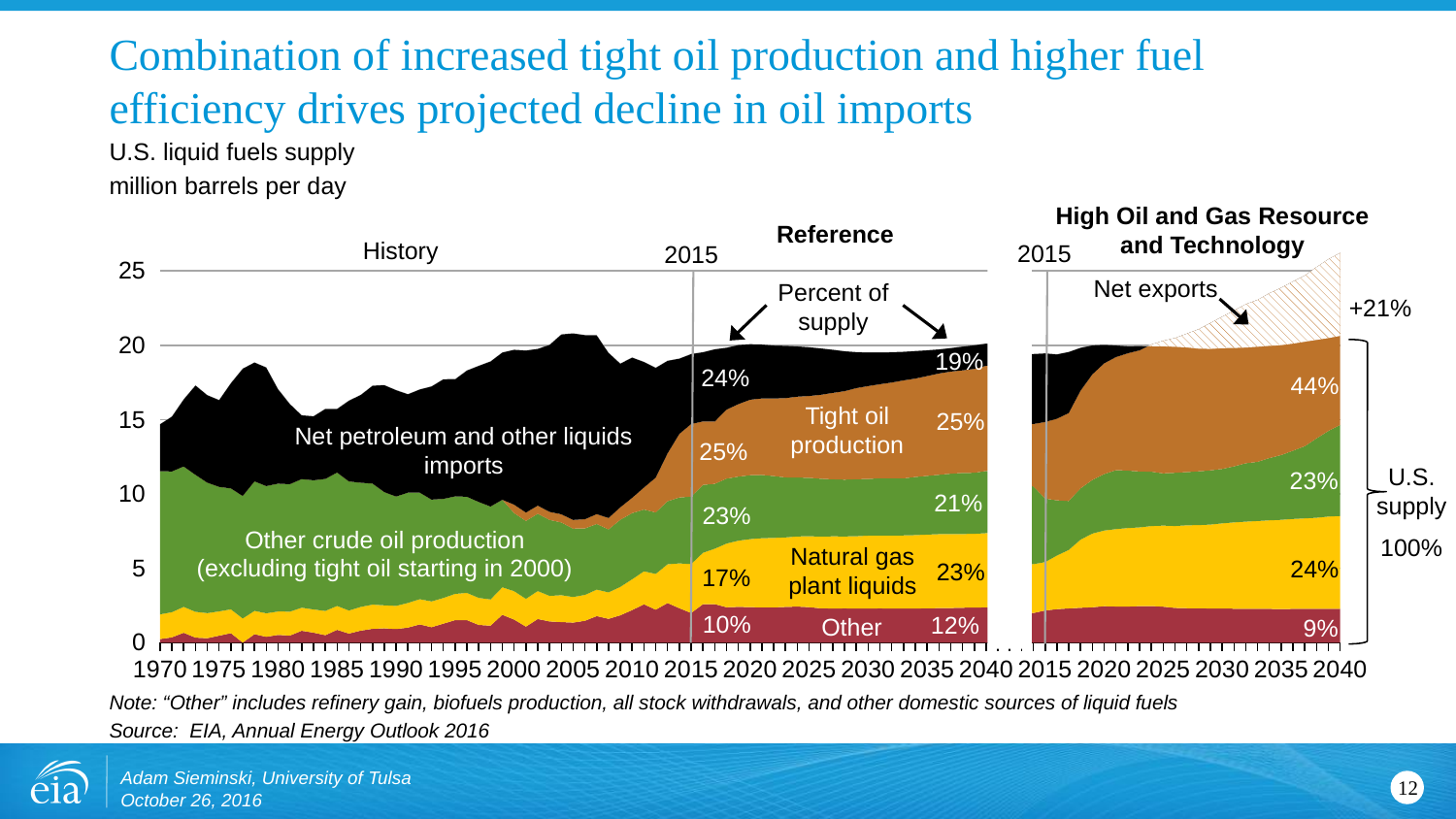
In the Reference case, what percent of supply do net petroleum and other liquids imports account for in 2040? 19% In the Reference case in 2015, which component has the smallest share of supply? Other In the High Oil and Gas Resource and Technology case, what percent of supply does 'Other' account for in 2040? 9% What kind of chart is shown on the slide? Stacked area chart In the Reference case, what percent of supply does tight oil production account for in 2015? 25% In the High Oil and Gas Resource and Technology case, what percent of supply does tight oil production account for in 2040? 44% In the Reference case, what percent of supply do natural gas plant liquids account for in 2015? 17% In the Reference case, by how many percentage points does the natural gas plant liquids share of supply change between 2015 and 2040? 6 percentage points What percentage is labeled for net exports in the High Oil and Gas Resource and Technology case? +21% Is total U.S. liquid fuels supply in 1970 greater or less than 20 million barrels per day? less In the High Oil and Gas Resource and Technology case in 2040, which component has the largest share of U.S. supply? Tight oil production In the Reference case in 2040, which has the larger share of supply: tight oil production or other crude oil production? Tight oil production